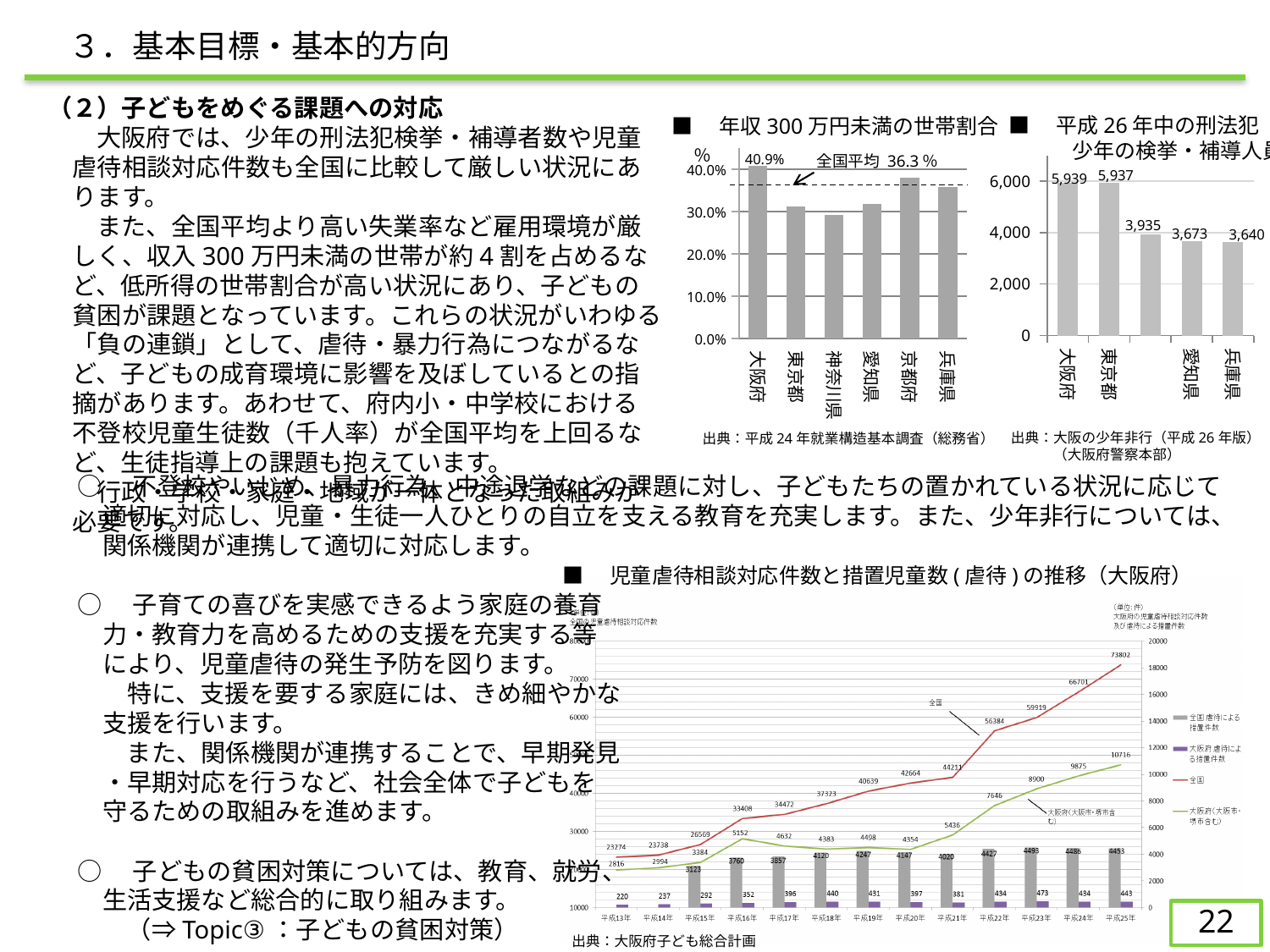
How many prefectures are shown in the chart titled 年収300万円未満の世帯割合? 6 In the chart titled 年収300万円未満の世帯割合, which prefecture has the lowest value? 神奈川県 In the chart titled 平成26年中の刑法犯少年の検挙・補導人員, what is the difference between 大阪府 and 東京都? 2 What kind of chart is the one titled 平成26年中の刑法犯少年の検挙・補導人員? bar chart In the chart titled 年収300万円未満の世帯割合, what is the 全国平均 value shown? 36.3% In the chart titled 年収300万円未満の世帯割合, is the value for 東京都 greater or less than 40.0%? less How many series does the legend list in the chart titled 児童虐待相談対応件数と措置児童数(虐待)の推移（大阪府）? 4 In the chart titled 児童虐待相談対応件数と措置児童数(虐待)の推移（大阪府）, what is the 全国 value for 平成25年? 73802 In the chart titled 平成26年中の刑法犯少年の検挙・補導人員, which is larger, 愛知県 or 兵庫県? 愛知県 In the chart titled 平成26年中の刑法犯少年の検挙・補導人員, what is the value for 大阪府? 5,939 In the chart titled 年収300万円未満の世帯割合, which prefecture has the highest value? 大阪府 In the chart titled 年収300万円未満の世帯割合, what is the value for 大阪府? 40.9%